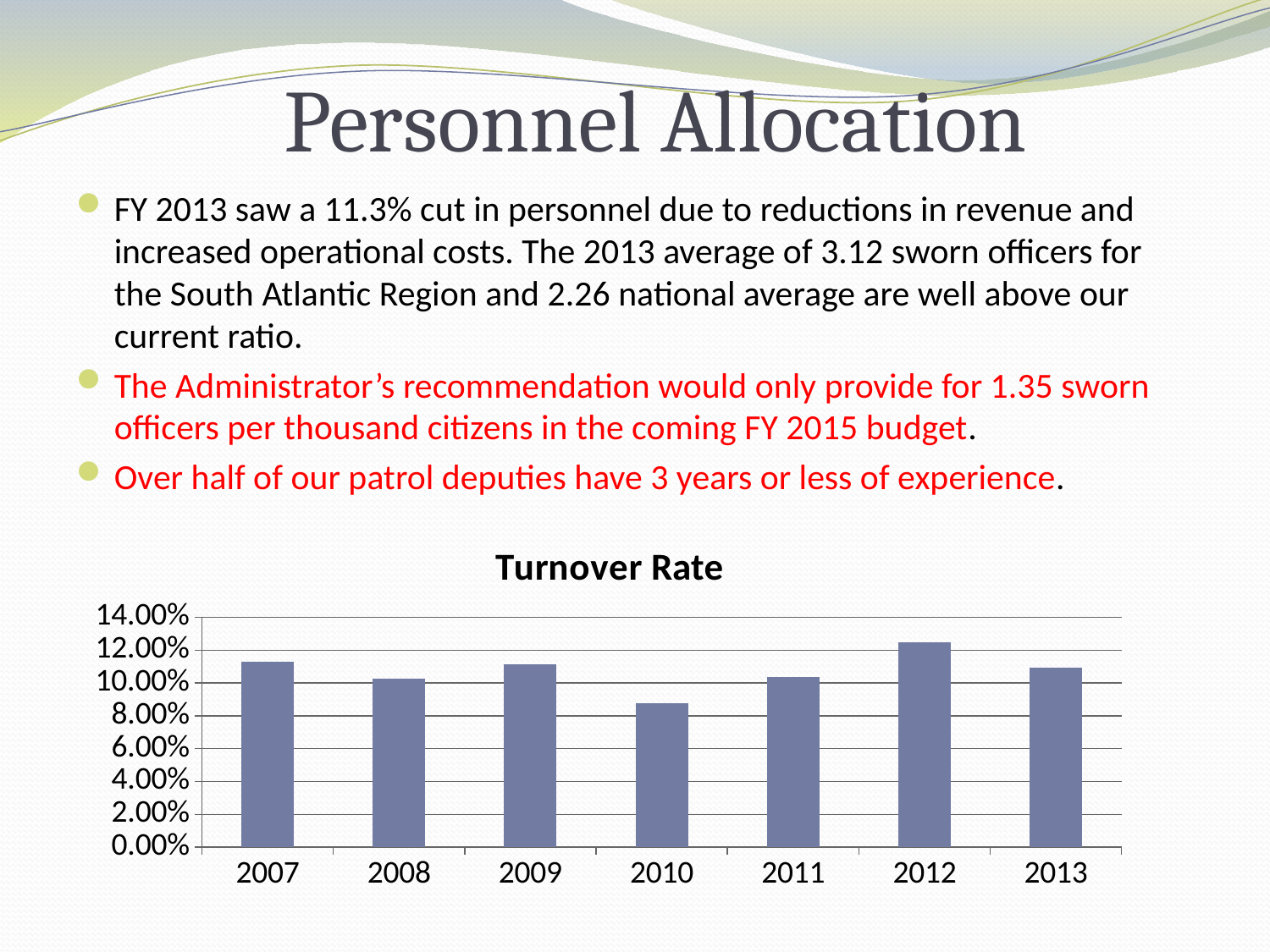
Is the turnover rate for 2010 greater or less than 8.00%? greater What kind of chart is the Turnover Rate chart? bar chart Does the turnover rate rise or fall from 2012 to 2013? fall Which year has a higher turnover rate, 2009 or 2010? 2009 Which year has the highest turnover rate? 2012 Is the turnover rate for 2007 greater or less than 10.00%? greater Which year has the lowest turnover rate? 2010 Which year has a higher turnover rate, 2007 or 2008? 2007 How many years are shown on the x axis of the Turnover Rate chart? 7 Is the turnover rate for 2012 greater or less than 12.00%? greater What is the title of the chart on the slide? Turnover Rate